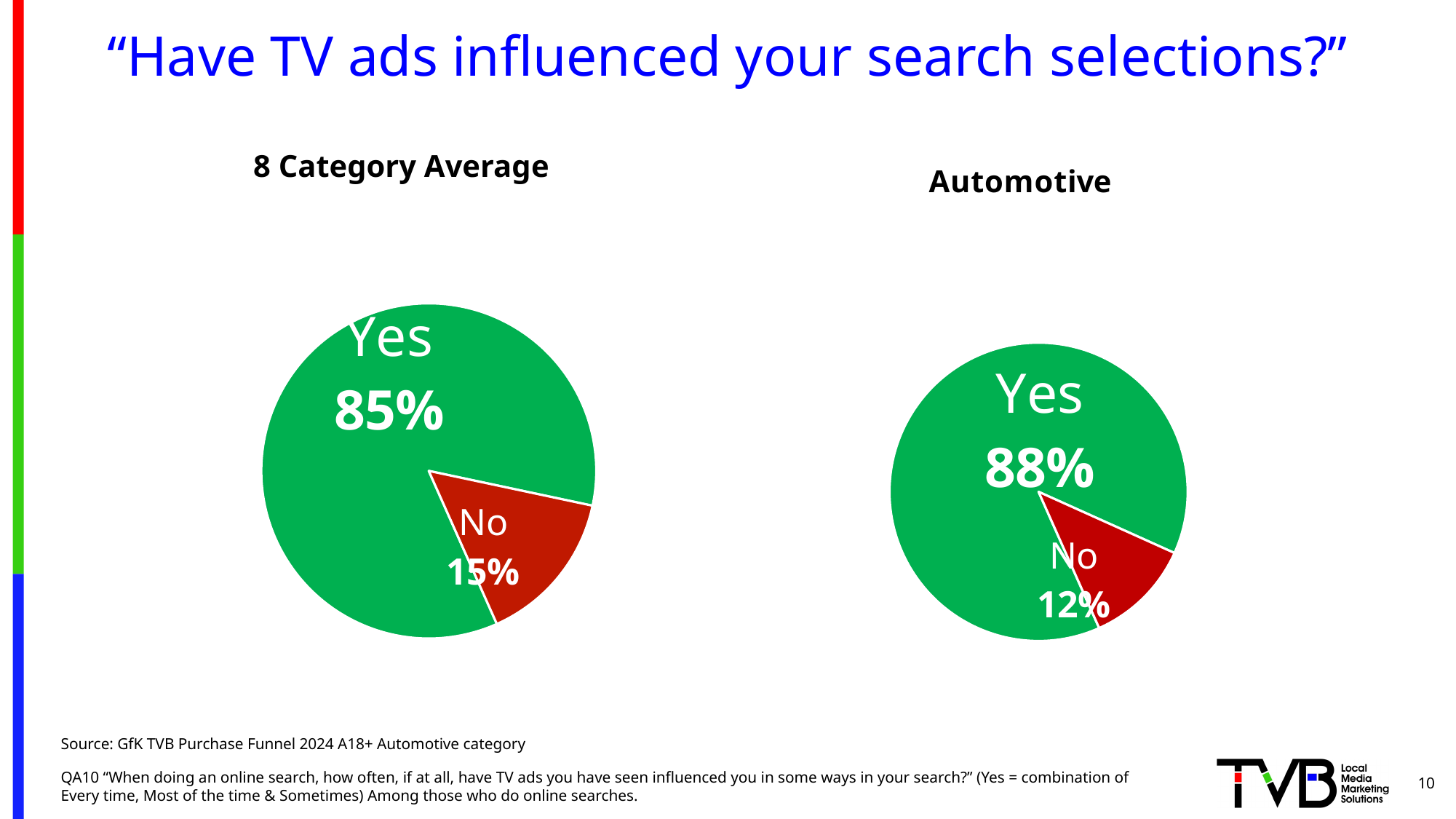
In the Automotive chart, what share of the pie does the No slice represent? 12% How many slices does the 8 Category Average pie chart have? 2 In the 8 Category Average chart, what colour is the No slice? Red What kind of chart is the Automotive chart? Pie chart Is the Yes share larger in the 8 Category Average chart or the Automotive chart? Automotive In the 8 Category Average chart, what percentage answered No? 15% In the 8 Category Average chart, what is the difference between the Yes and No percentages? 70% In the Automotive chart, which slice is the largest? Yes In the Automotive chart, what percentage answered No? 12% In the 8 Category Average chart, what percentage answered Yes? 85% In the 8 Category Average chart, which slice is the smallest? No In the Automotive chart, what percentage answered Yes? 88%